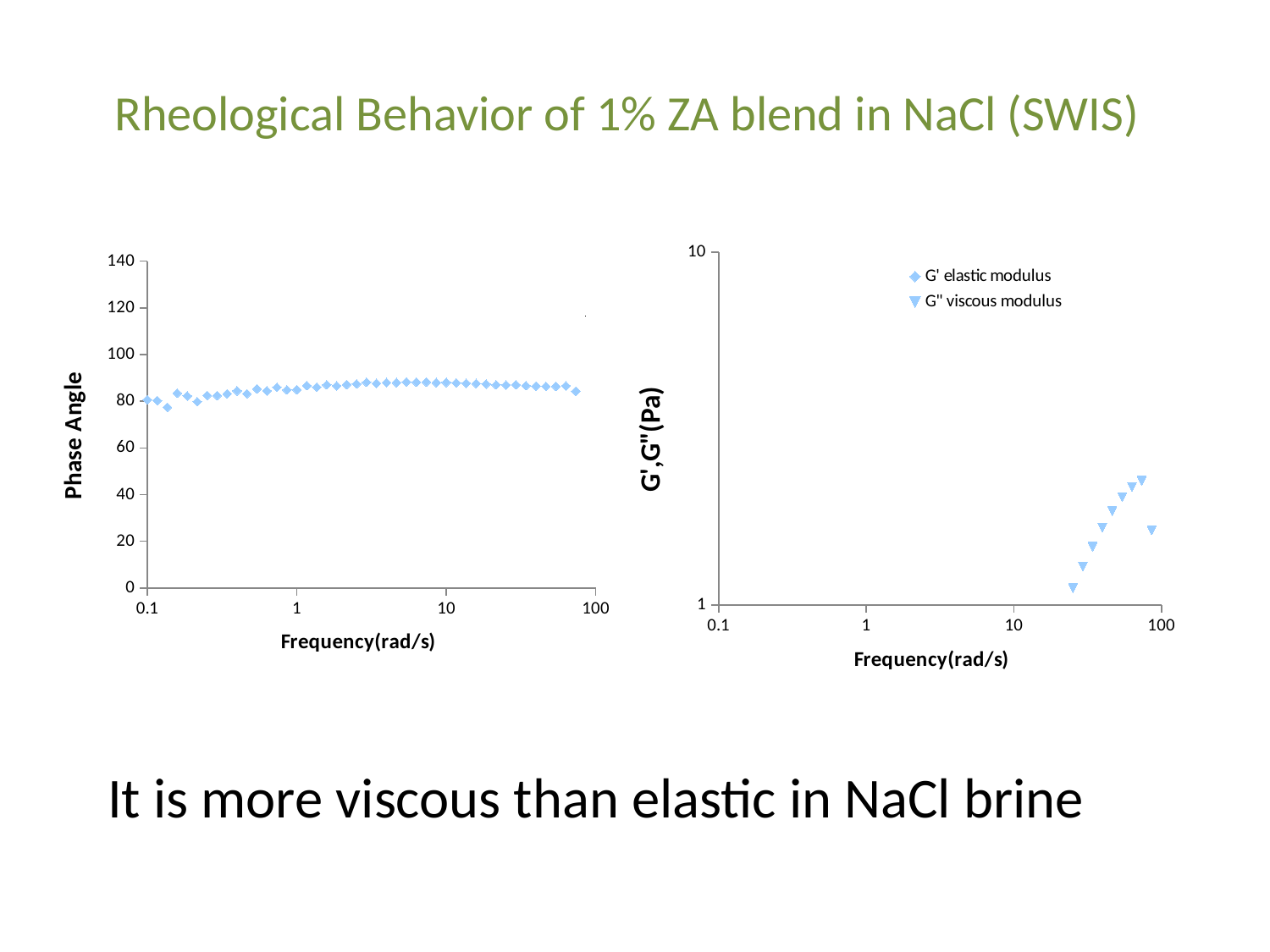
What is the y-axis title of the left chart? Phase Angle What is the maximum value shown on the y-axis of the left chart? 140 In the left chart, is the phase angle at a frequency of 10 rad/s greater or less than 60? greater In the right chart, is the G'' viscous modulus value at about 30 rad/s greater or less than 10 Pa? less What kind of chart is the left chart showing Phase Angle against Frequency? scatter plot What are the two series named in the legend of the right chart? G' elastic modulus and G'' viscous modulus In the left chart, does the phase angle stay roughly constant, rise sharply, or fall sharply as frequency increases from 0.1 to 100 rad/s? roughly constant In the left chart, is the phase angle at a frequency of 1 rad/s greater or less than 100? less How many series does the legend of the right chart list? 2